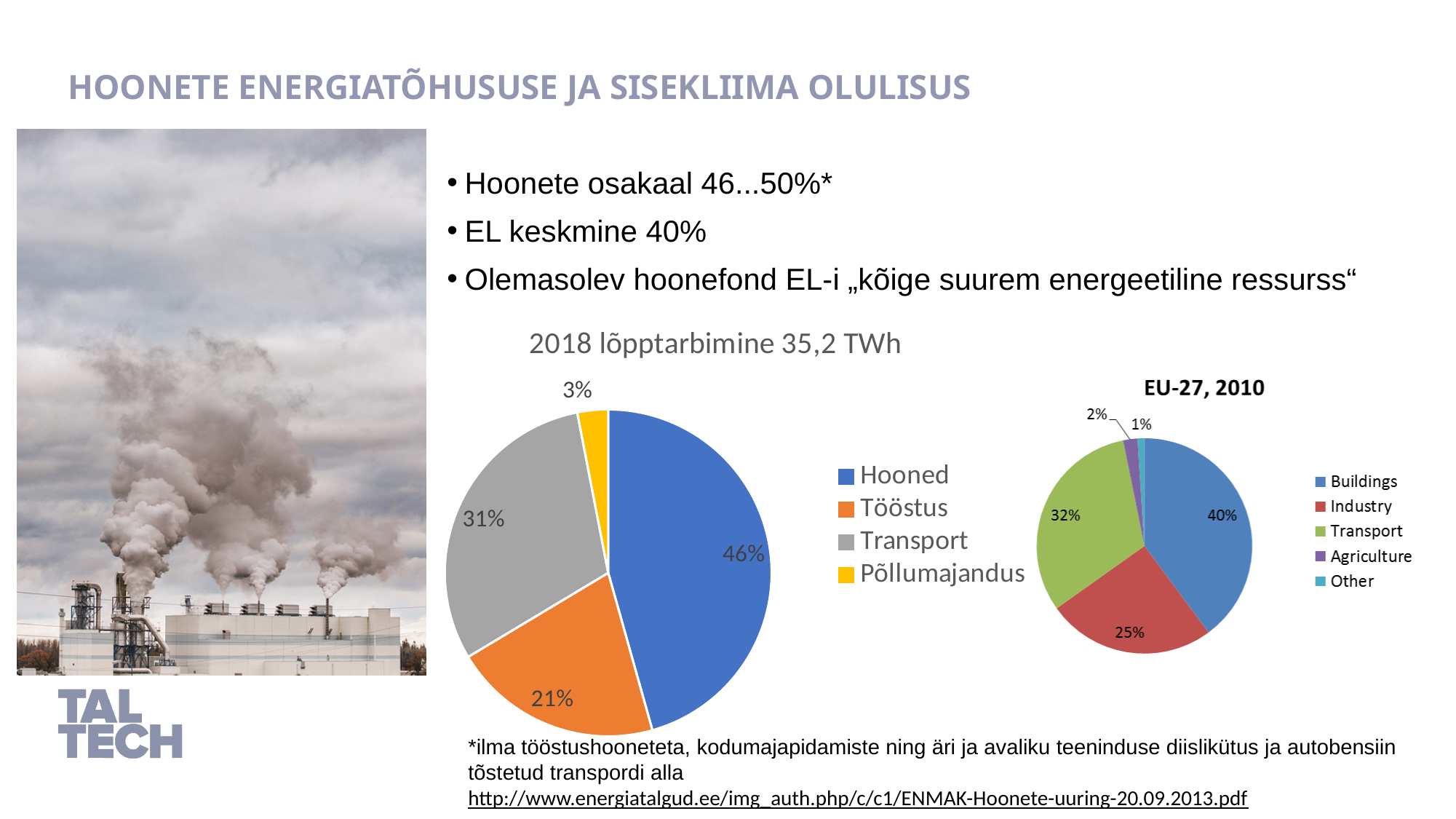
In the 'EU-27, 2010' pie chart, which is larger, Buildings or Transport? Buildings In the 'EU-27, 2010' pie chart, what share does Industry have? 25% In the '2018 lõpptarbimine 35,2 TWh' pie chart, what share does Transport have? 31% How many categories does the legend of the 'EU-27, 2010' pie chart list? 5 In the 'EU-27, 2010' pie chart, what colour is the Transport slice? Green What type of chart is the 'EU-27, 2010' chart? Pie chart How many categories does the legend of the '2018 lõpptarbimine 35,2 TWh' pie chart list? 4 In the '2018 lõpptarbimine 35,2 TWh' pie chart, what share does Hooned have? 46% In the '2018 lõpptarbimine 35,2 TWh' pie chart, what is the difference between the Transport and Tööstus shares? 10% In the 'EU-27, 2010' pie chart, what share does Agriculture have? 2% In the '2018 lõpptarbimine 35,2 TWh' pie chart, which category has the largest share? Hooned In the '2018 lõpptarbimine 35,2 TWh' pie chart, which category has the smallest share? Põllumajandus